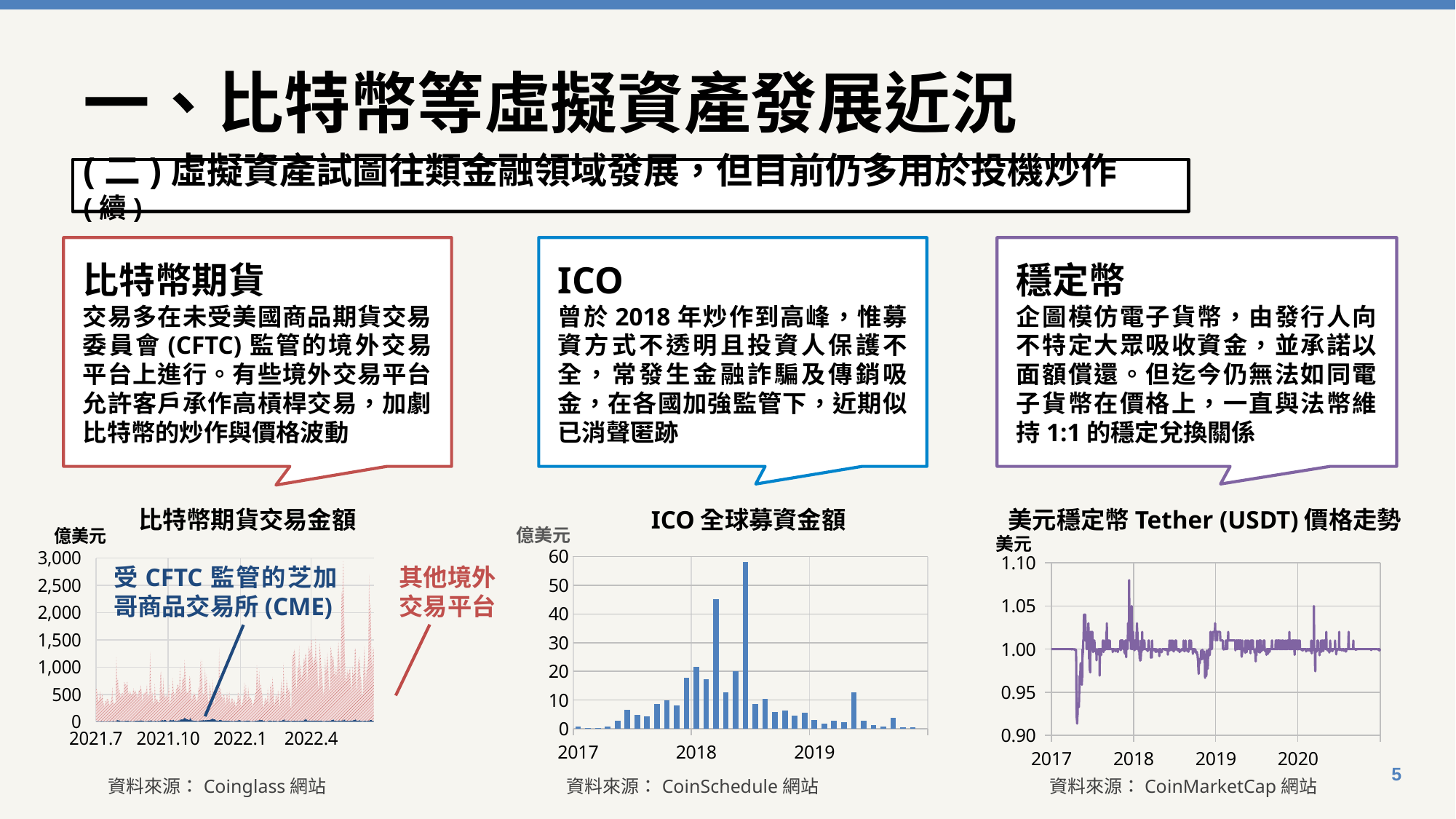
In the '美元穩定幣 Tether (USDT) 價格走勢' chart, is the lowest point of the line greater or less than 0.95? less What kind of chart is the '美元穩定幣 Tether (USDT) 價格走勢' chart? line chart What is the data source given for the '美元穩定幣 Tether (USDT) 價格走勢' chart? CoinMarketCap 網站 In the '比特幣期貨交易金額' chart, which series is larger throughout: 受 CFTC 監管的芝加哥商品交易所 (CME) or 其他境外交易平台? 其他境外交易平台 In the '比特幣期貨交易金額' chart, is the peak value for 其他境外交易平台 greater or less than 2,000? greater In the 'ICO 全球募資金額' chart, is the tallest bar greater or less than 50? greater In the 'ICO 全球募資金額' chart, in which year labelled on the x axis does the tallest bar occur? 2018 What unit is shown on the y axis of the '比特幣期貨交易金額' chart? 億美元 What kind of chart is the 'ICO 全球募資金額' chart? bar chart How many charts are shown on the slide? 3 In the 'ICO 全球募資金額' chart, do the values rise or fall from 2018 to 2019? fall